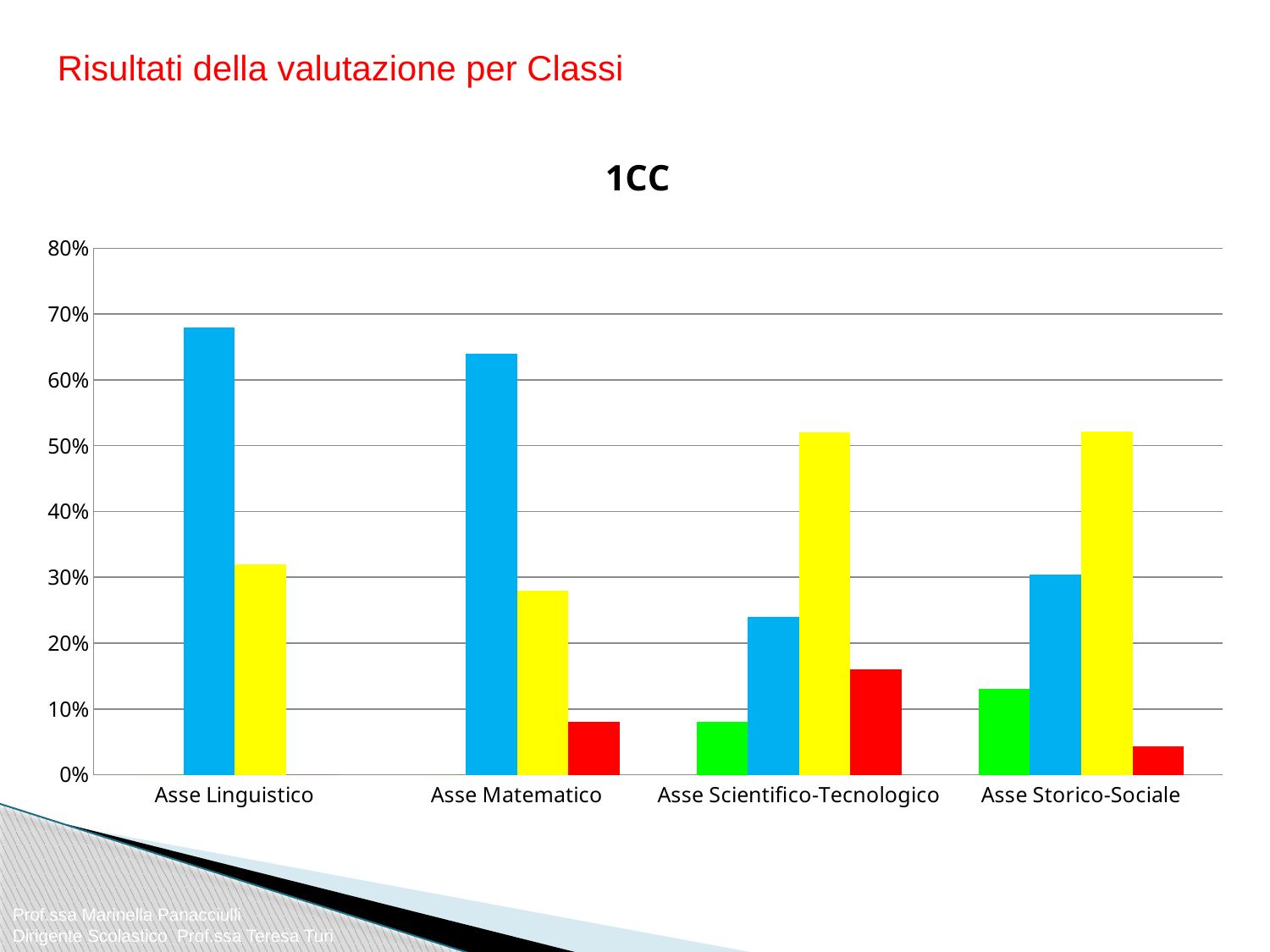
Is the value of the yellow bar for Asse Storico-Sociale greater or less than 40%? greater Is the value of the yellow bar for Asse Matematico greater or less than 40%? less Is the value of the red bar for Asse Storico-Sociale greater or less than 10%? less How many categories are shown on the x axis of the chart? 4 For Asse Linguistico, which is taller: the blue bar or the yellow bar? the blue bar Which category has the shortest red bar? Asse Storico-Sociale What kind of chart is shown on the slide? bar chart For Asse Scientifico-Tecnologico, which is taller: the yellow bar or the blue bar? the yellow bar Which category has the tallest green bar? Asse Storico-Sociale What is the title of the chart? 1CC